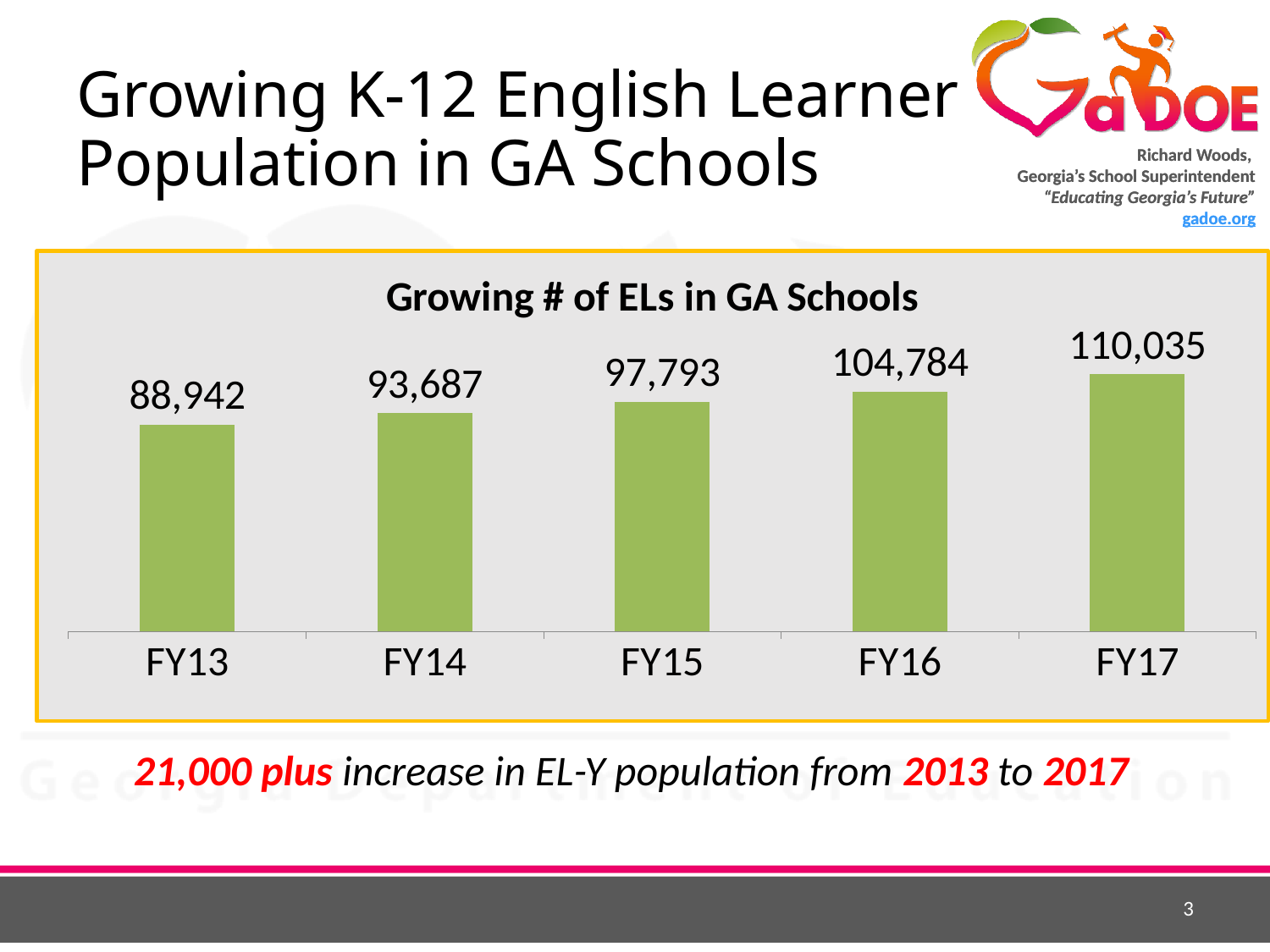
Which is larger, the value for FY14 or the value for FY16? FY16 How many fiscal years are shown on the chart? 5 What is the value for FY15? 97,793 What kind of chart is shown? Bar chart What is the difference between the FY17 and FY13 values? 21,093 Which fiscal year has the highest value? FY17 What is the value for FY13? 88,942 Do the values rise or fall from FY13 to FY17? Rise What is the difference between the FY16 and FY15 values? 6,991 What is the title of the chart? Growing # of ELs in GA Schools Which fiscal year has the lowest value? FY13 What is the value for FY17? 110,035